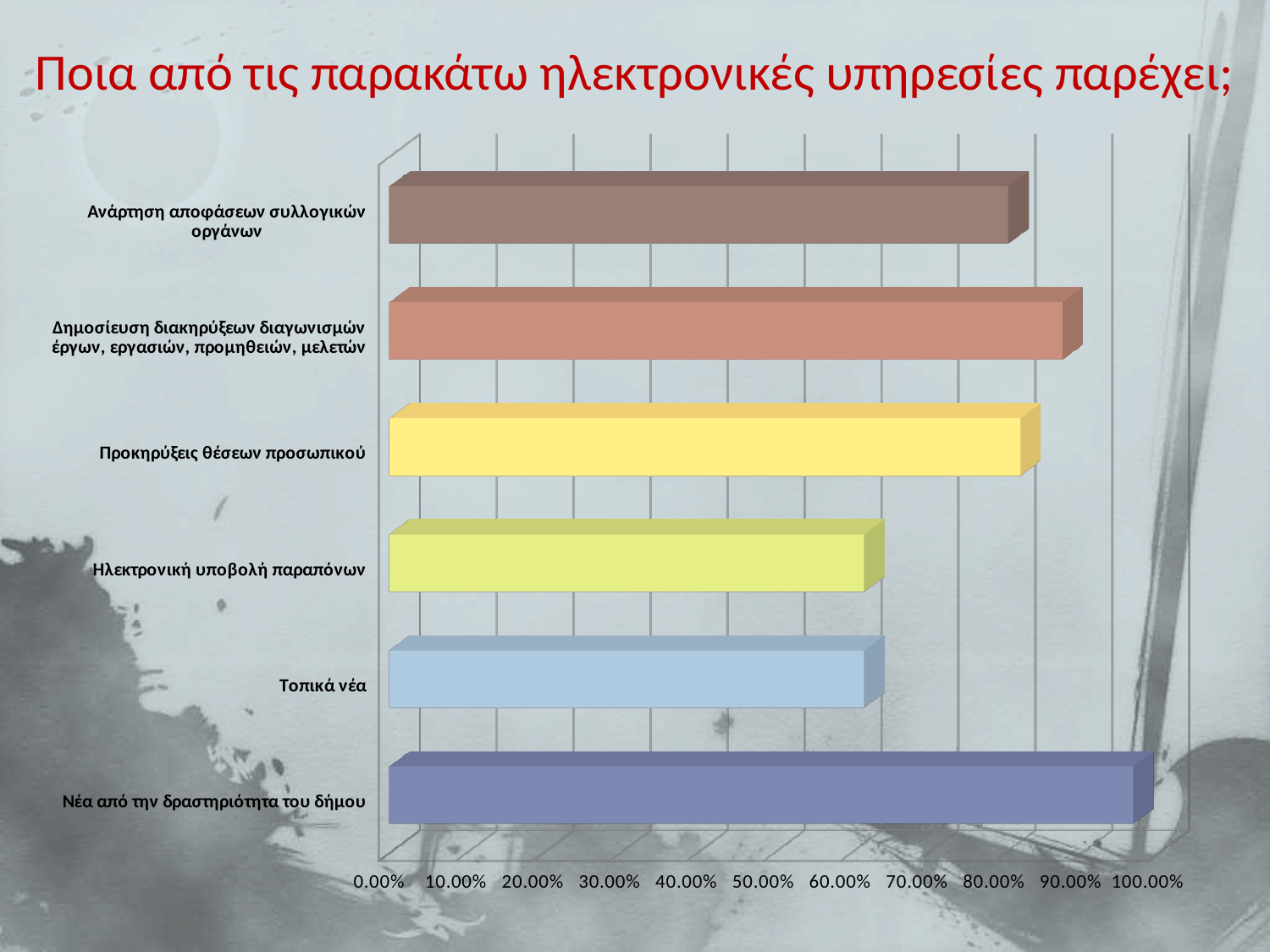
Which category has the highest value in the chart? Νέα από την δραστηριότητα του δήμου Which is larger: the value for Προκηρύξεις θέσεων προσωπικού or the value for Ηλεκτρονική υποβολή παραπόνων? Προκηρύξεις θέσεων προσωπικού Which is larger: the value for Δημοσίευση διακηρύξεων διαγωνισμών έργων, εργασιών, προμηθειών, μελετών or the value for Ανάρτηση αποφάσεων συλλογικών οργάνων? Δημοσίευση διακηρύξεων διαγωνισμών έργων, εργασιών, προμηθειών, μελετών Is the value for Νέα από την δραστηριότητα του δήμου greater or less than 90.00%? greater Is the value for Τοπικά νέα greater or less than 50.00%? greater Is the value for Ηλεκτρονική υποβολή παραπόνων greater or less than 70.00%? less How many categories (services) are plotted in the chart? 6 Which is larger: the value for Νέα από την δραστηριότητα του δήμου or the value for Τοπικά νέα? Νέα από την δραστηριότητα του δήμου What is the title of the slide above the chart? Ποια από τις παρακάτω ηλεκτρονικές υπηρεσίες παρέχει; What kind of chart is shown on the slide? bar chart